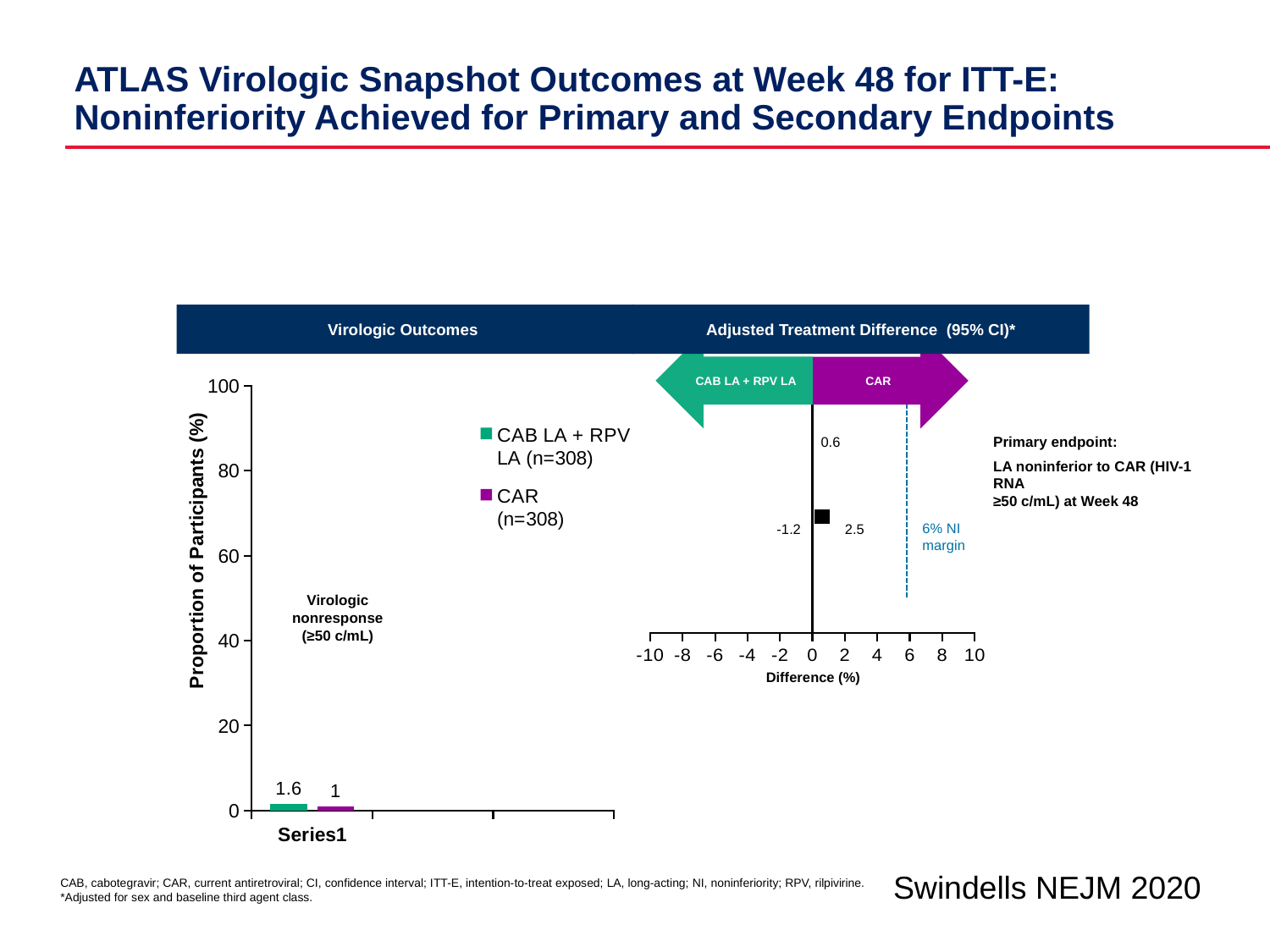
In the Virologic Outcomes bar chart, is the value for CAB LA + RPV LA greater or less than 20? less In the Adjusted Treatment Difference chart on the right, what is the upper bound of the 95% CI? 2.5 How many series does the legend of the Virologic Outcomes bar chart list? 2 What kind of chart is the Virologic Outcomes chart on the left? bar chart In the Virologic Outcomes bar chart, what is the value for CAR? 1 In the Adjusted Treatment Difference chart on the right, what is the point estimate of the treatment difference? 0.6 What is the y-axis label of the Virologic Outcomes bar chart? Proportion of Participants (%) In the Virologic Outcomes bar chart, what sample size is shown in the legend for CAR? n=308 In the Adjusted Treatment Difference chart on the right, what is the lower bound of the 95% CI? -1.2 In the Virologic Outcomes bar chart, what is the difference between the CAB LA + RPV LA bar and the CAR bar? 0.6 In the Virologic Outcomes bar chart, what is the value for CAB LA + RPV LA? 1.6 In the Virologic Outcomes bar chart, which series has the higher bar, CAB LA + RPV LA or CAR? CAB LA + RPV LA